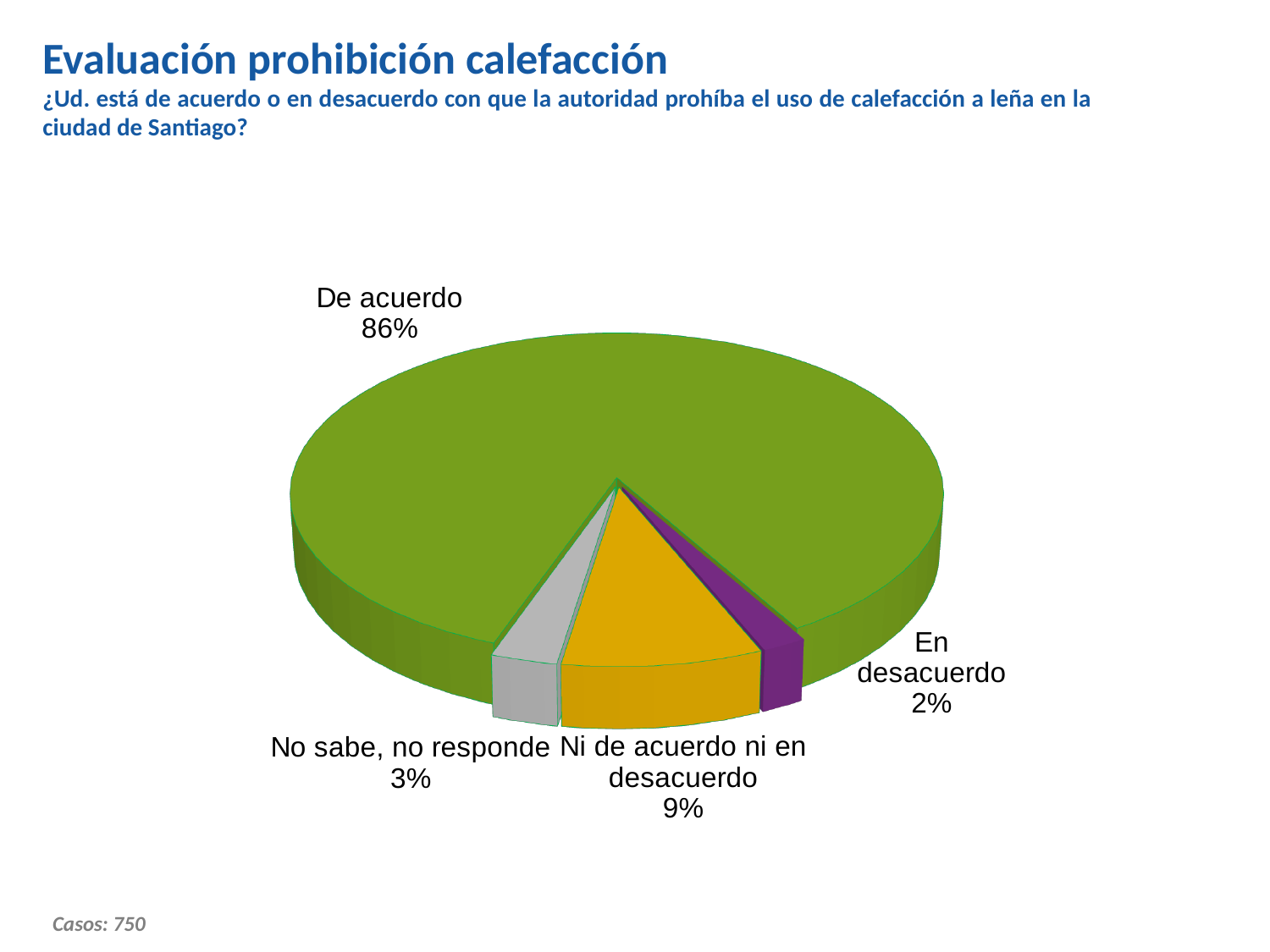
What kind of chart is shown on the slide? Pie chart What percentage of respondents answered "De acuerdo"? 86% What percentage of respondents answered "Ni de acuerdo ni en desacuerdo"? 9% What colour is the "De acuerdo" slice of the pie? Green What is the combined share of "Ni de acuerdo ni en desacuerdo" and "En desacuerdo"? 11% What percentage of respondents answered "No sabe, no responde"? 3% Which is larger: the share for "No sabe, no responde" or the share for "En desacuerdo"? No sabe, no responde What percentage of respondents answered "En desacuerdo"? 2% What is the difference in percentage points between "De acuerdo" and "Ni de acuerdo ni en desacuerdo"? 77 How many response categories are shown in the pie chart? 4 Which response category has the largest share of the pie? De acuerdo Which response category has the smallest share of the pie? En desacuerdo